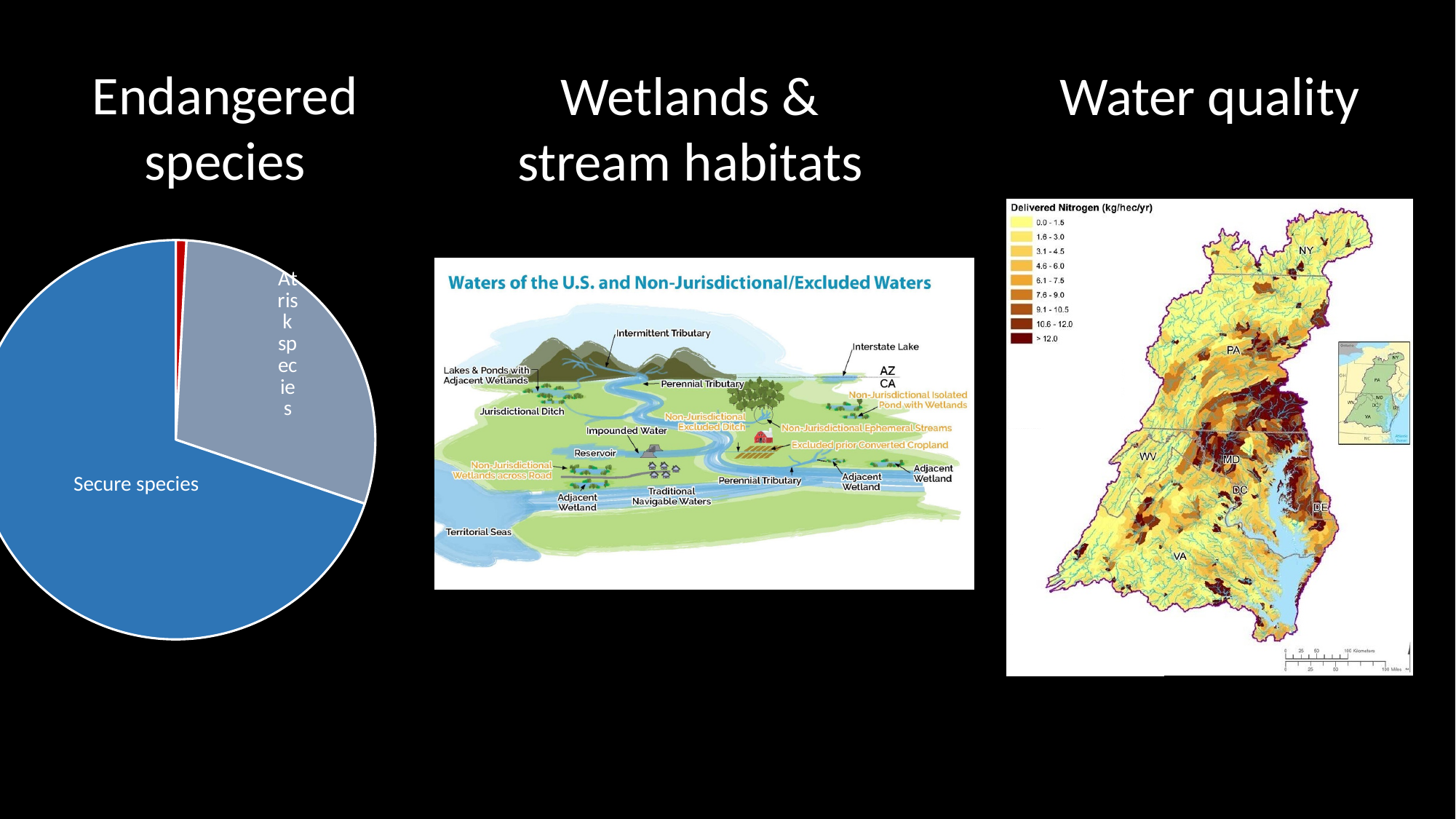
In the Endangered species pie chart, which category has the largest slice? Secure species In the Endangered species pie chart, which is larger: Secure species or At risk species? Secure species What kind of chart is shown under the heading "Endangered species"? pie chart What colour is the At risk species slice in the Endangered species pie chart? grey What colour is the Secure species slice in the Endangered species pie chart? blue In the Endangered species pie chart, does the Secure species slice take up more or less than half of the pie? more How many slices does the Endangered species pie chart have? 3